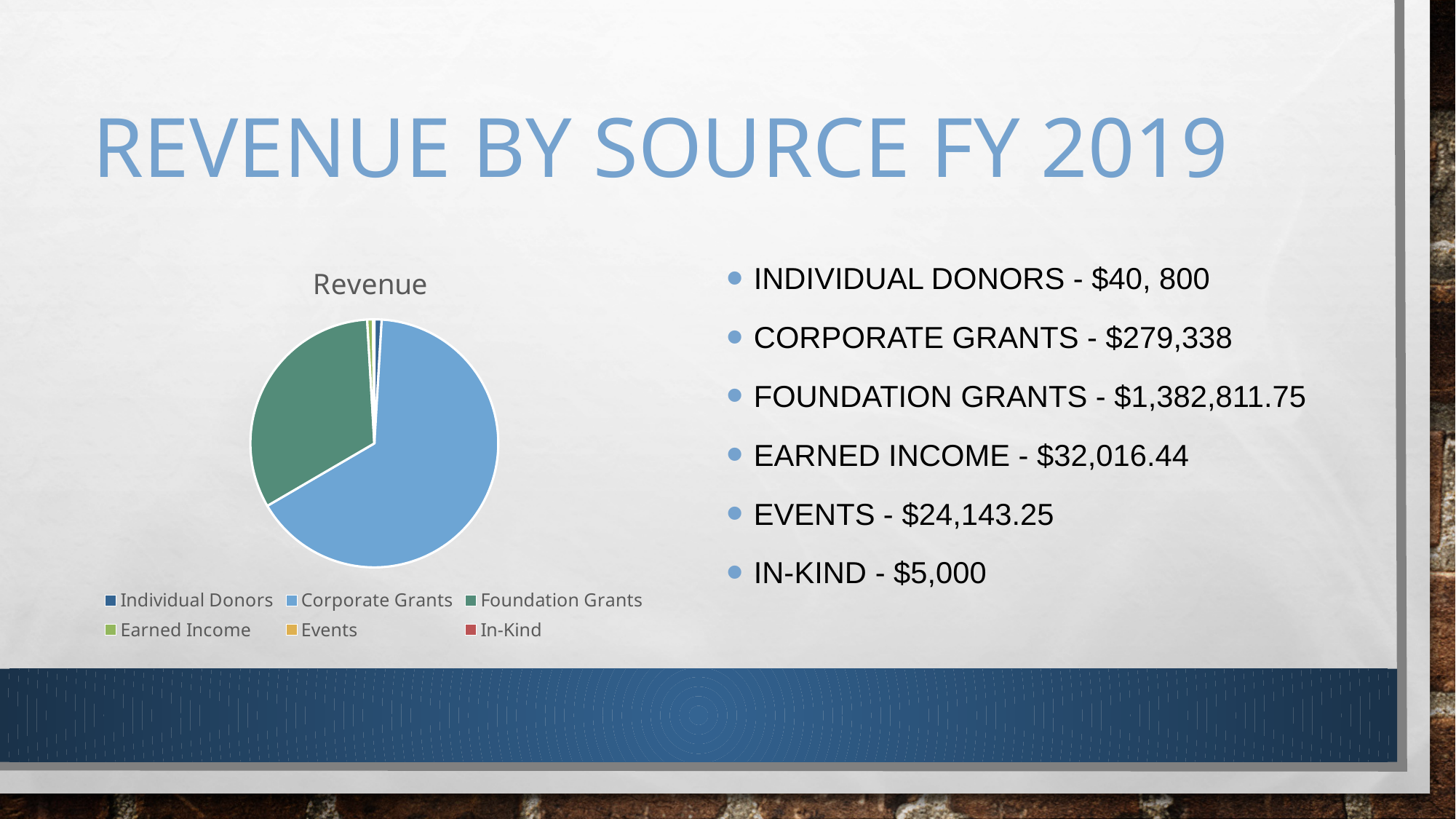
What is the revenue from Corporate Grants? $279,338 What is the revenue from Foundation Grants? $1,382,811.75 What is the revenue from Earned Income? $32,016.44 What is the revenue from Events? $24,143.25 What is the difference between the Events revenue and the In-Kind revenue? $19,143.25 Which is larger, the revenue from Individual Donors or from Corporate Grants? Corporate Grants What is the revenue from In-Kind? $5,000 How many categories does the pie chart's legend list? 6 What kind of chart is shown on the slide? pie chart What is the title of the chart? Revenue Which colour represents Foundation Grants in the legend? green What is the revenue from Individual Donors? $40, 800